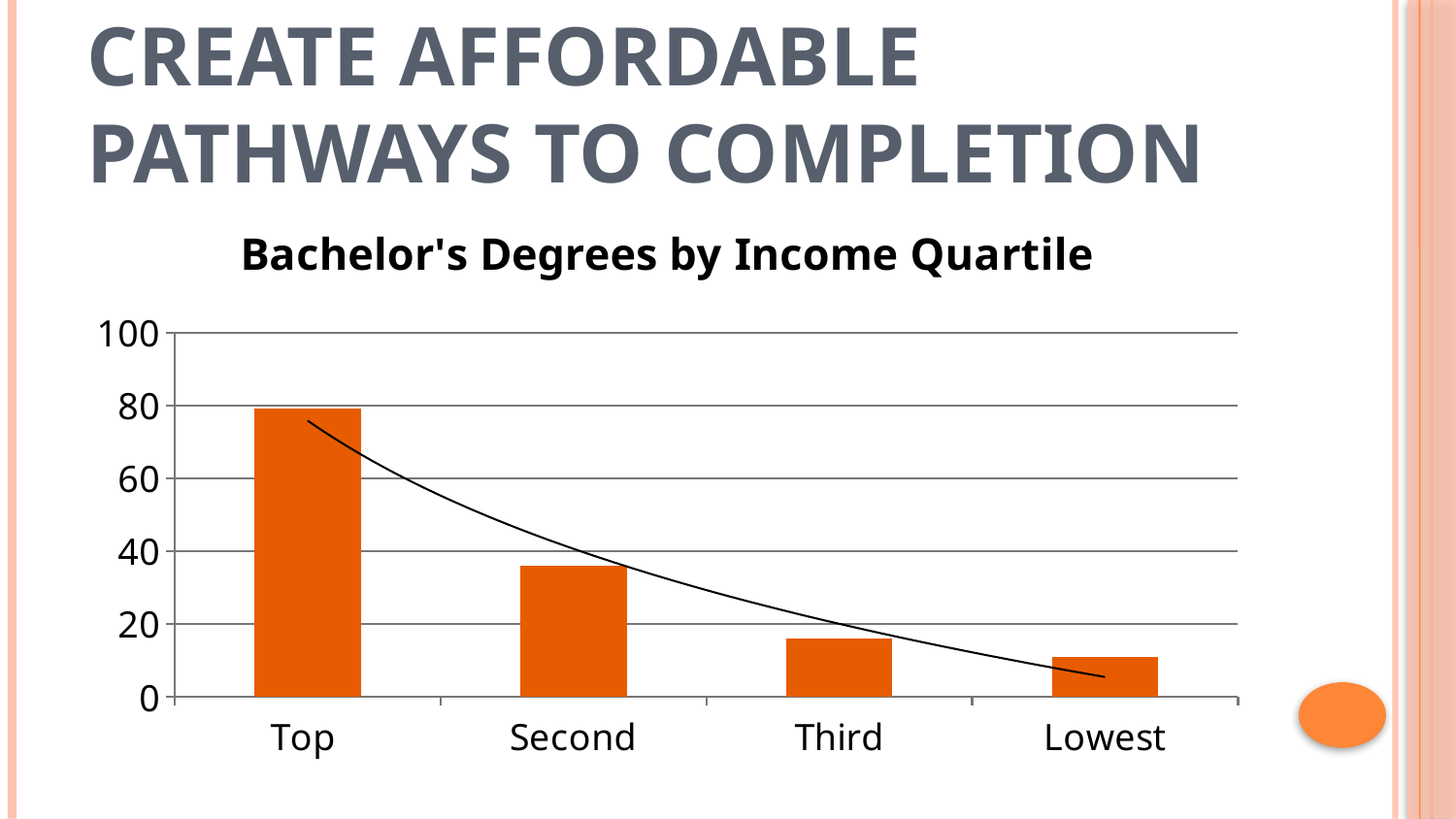
How many income quartile categories are shown on the x axis? 4 Is the value for Third greater or less than 20? less Is the value for Second greater or less than 40? less What kind of chart is shown on the slide? bar chart What is the title of the chart? Bachelor's Degrees by Income Quartile Is the value for Top greater or less than 60? greater Which is larger, the value for Second or the value for Third? Second Which income quartile has the highest value? Top Which income quartile has the lowest value? Lowest What colour are the bars in the chart? orange Do the values rise or fall moving from Top to Lowest along the x axis? fall